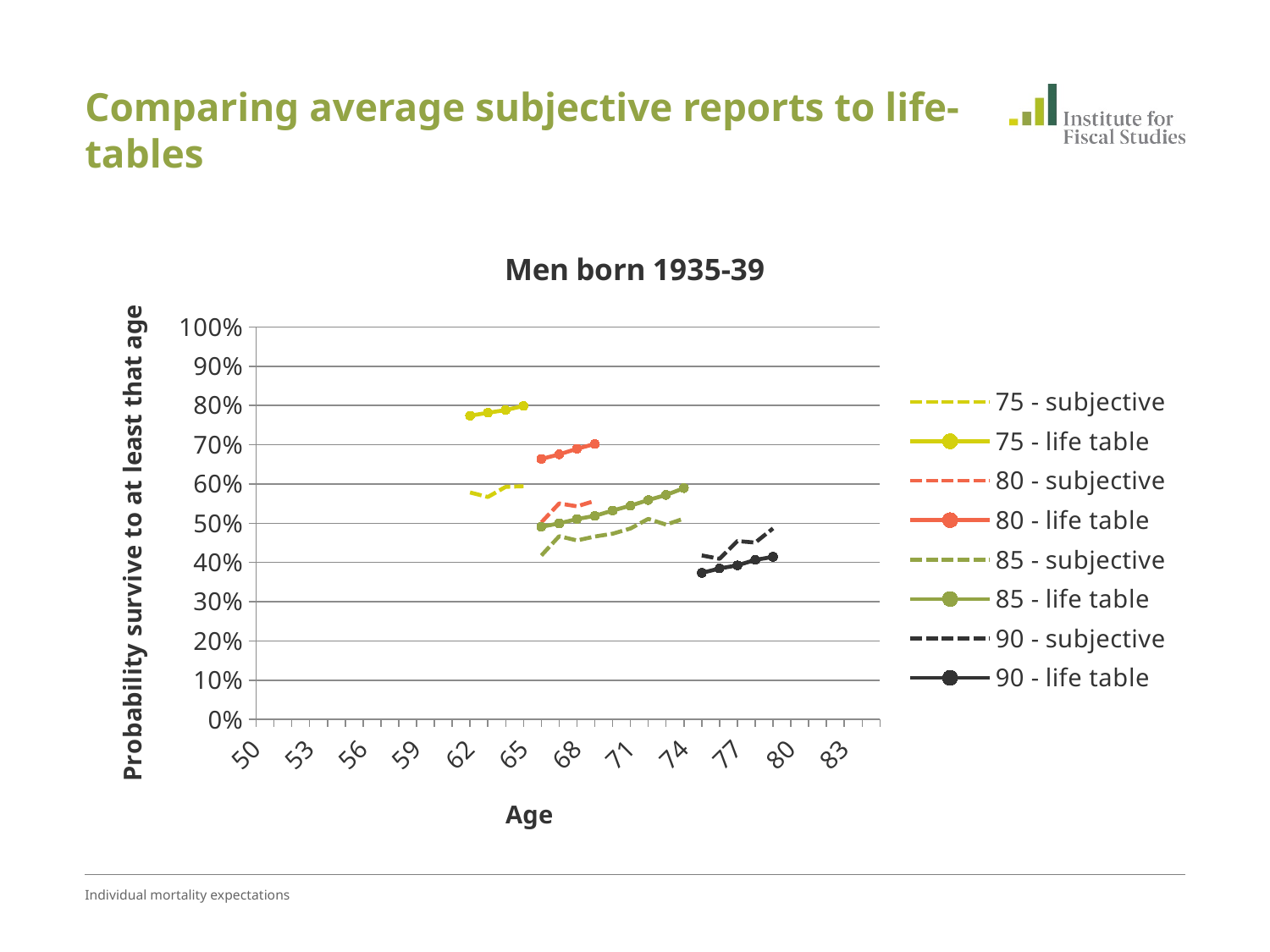
Do the values of the 85 - life table series rise or fall as age increases? rise What kind of chart is shown on the slide? line chart Is the value for the 75 - life table series at age 62 greater or less than 70%? greater Which series has the highest values on the chart? 75 - life table Which series has the lowest values on the chart? 90 - life table Which is higher at age 63: the 75 - life table series or the 75 - subjective series? 75 - life table What is the label of the vertical axis? Probability survive to at least that age Is the value for the 90 - life table series at age 75 greater or less than 50%? less Is the value for the 80 - life table series at age 67 greater or less than 60%? greater What is the title of the chart? Men born 1935-39 How many series does the legend list? 8